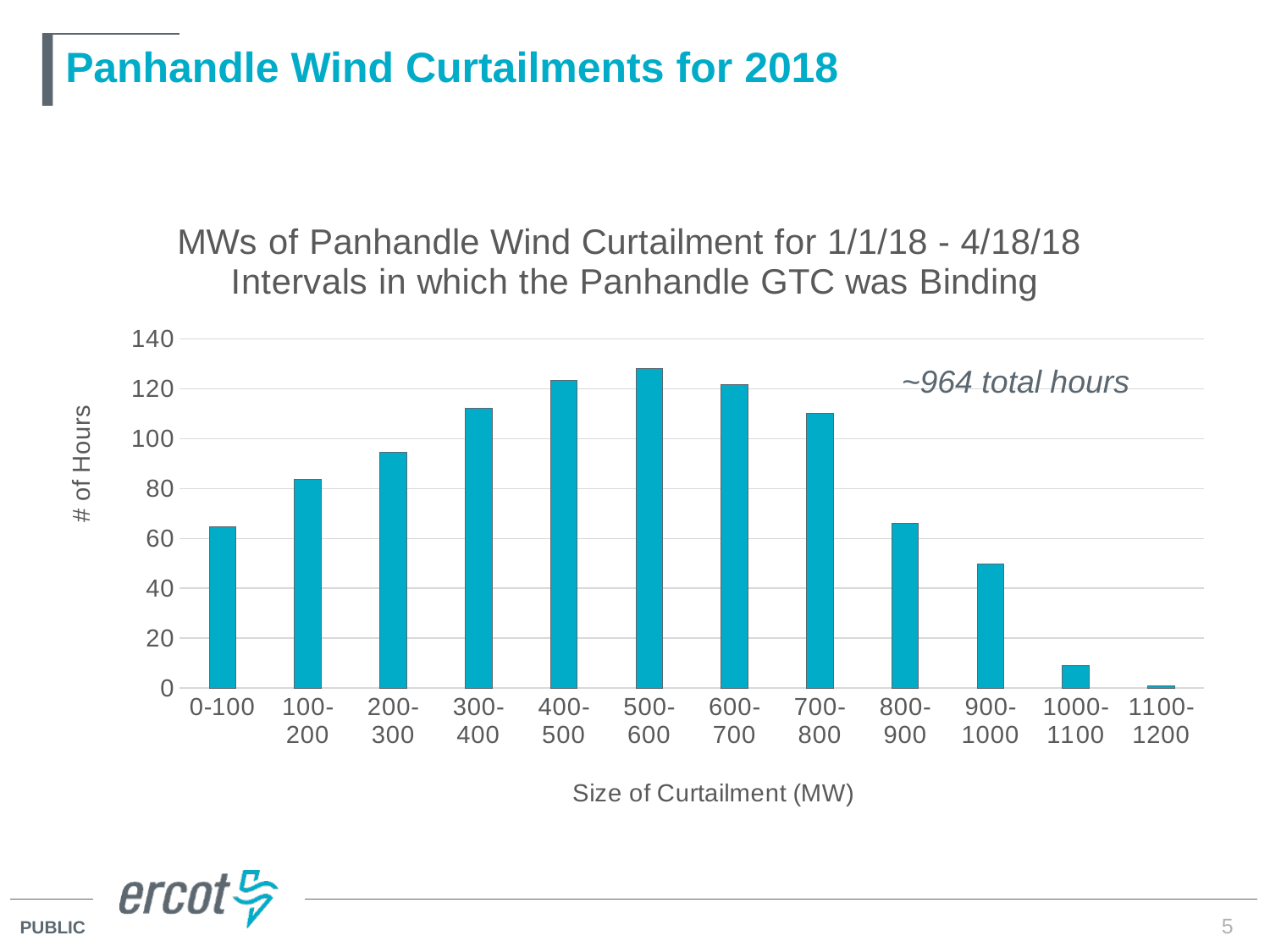
Do the number of hours rise or fall moving from the 700-800 category to the 1100-1200 category? fall What is the title of the x axis? Size of Curtailment (MW) How many curtailment size categories are shown on the x axis? 12 Is the number of hours for the 0-100 category greater or less than 60? greater Which has more hours, the 100-200 category or the 800-900 category? 100-200 Is the number of hours for the 1000-1100 category greater or less than 20? less Is the number of hours for the 300-400 category greater or less than 100? greater Which curtailment size category has the highest number of hours? 500-600 Which curtailment size category has the lowest number of hours? 1100-1200 What kind of chart is shown on the slide? Bar chart What total number of hours is noted in the annotation on the chart? ~964 total hours